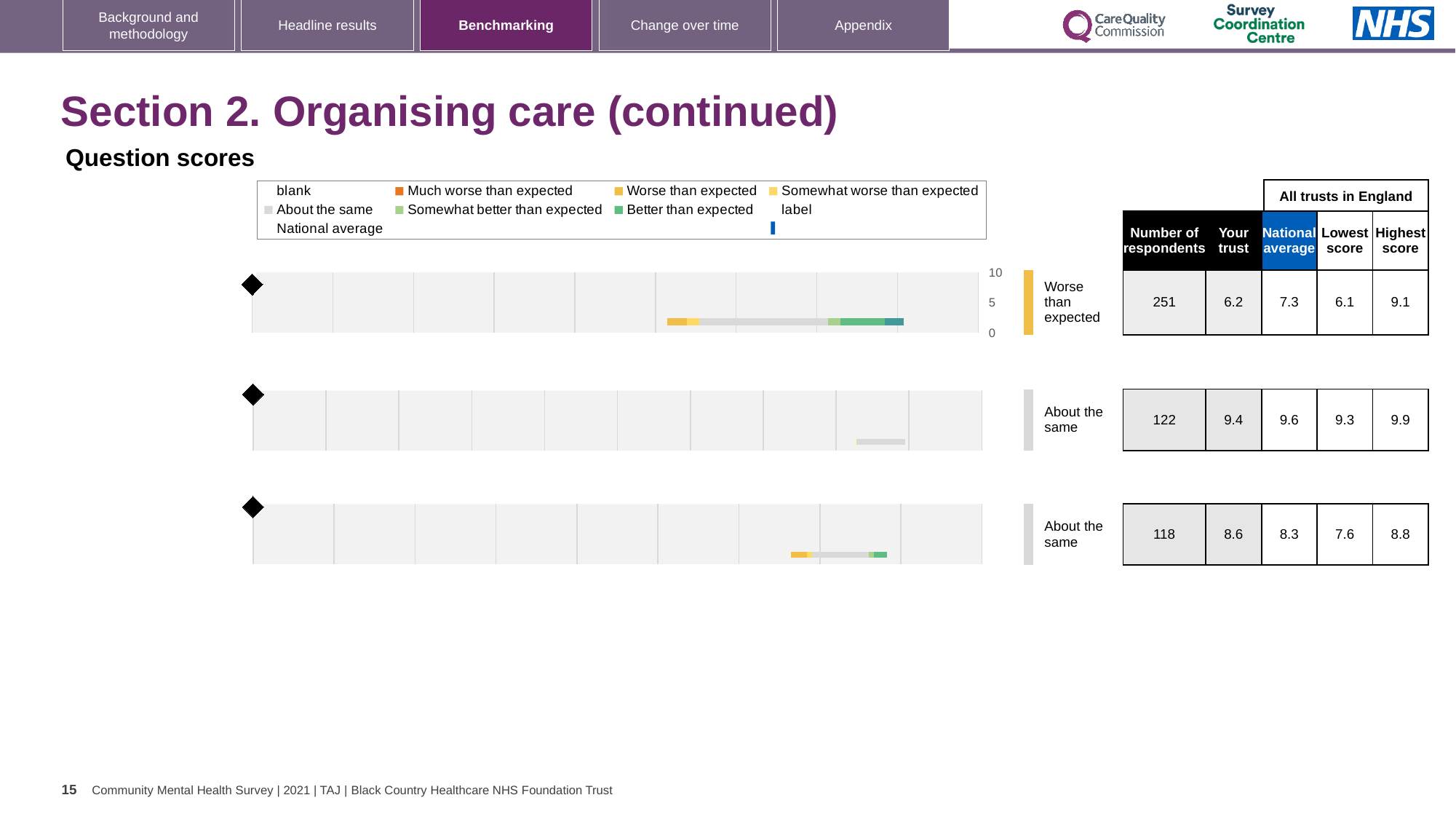
For the top chart, what is the difference between the highest score and the lowest score across all trusts in England? 3.0 For the bottom chart, what is the difference between the 'Your trust' score and the national average? 0.3 For the top chart, what is the national average score shown in the table? 7.3 For the top chart, what is the number of respondents? 251 For the top chart, what is the 'Your trust' score shown in the table? 6.2 For the bottom chart, what is the lowest score across all trusts in England? 7.6 For the middle chart, what is the 'Your trust' score? 9.4 For the bottom chart, what is the 'Your trust' score? 8.6 What type of chart is used for the top chart on the slide? bar chart What is the maximum value shown on the vertical axis of the top chart? 10 For the middle chart, which is larger: the 'Your trust' score or the national average? National average What benchmark category label is shown next to the top chart? Worse than expected